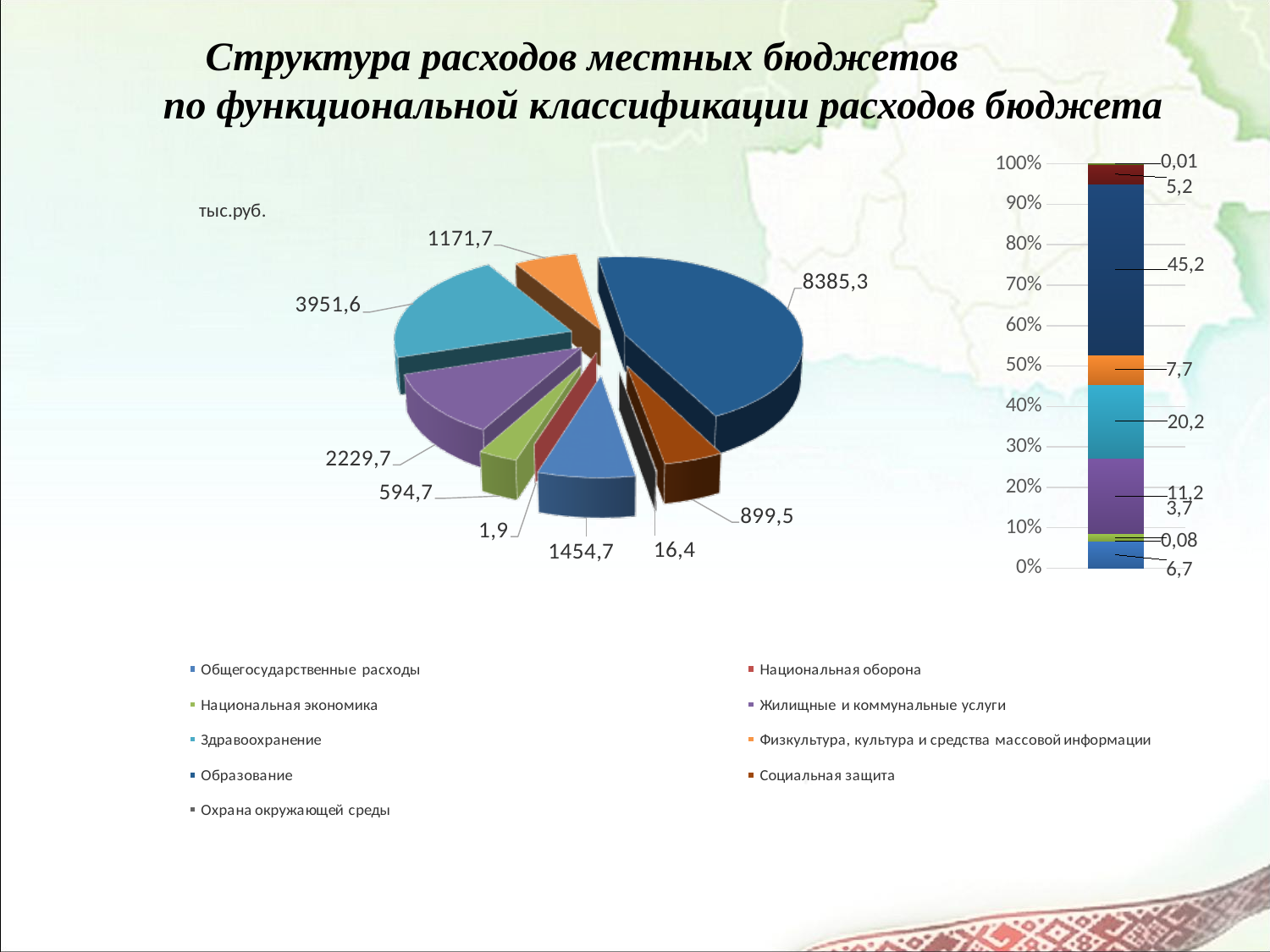
How many categories does the legend list? 9 What is the largest value labelled on the pie chart? 8385,3 How many slices does the pie chart have? 9 What is the smallest value labelled on the pie chart? 1,9 What is the title of the slide? Структура расходов местных бюджетов по функциональной классификации расходов бюджета What type of chart is shown on the left side of the slide? pie chart What unit is indicated next to the pie chart? тыс.руб. What is the largest segment value labelled on the stacked bar chart? 45,2 What type of chart is shown on the right side of the slide? stacked bar chart What is the smallest segment value labelled on the stacked bar chart? 0,01 On the pie chart, what is the difference between the largest slice (8385,3) and the slice labelled 3951,6? 4433,7 On the pie chart, which is larger: the slice labelled 2229,7 or the slice labelled 1454,7? 2229,7